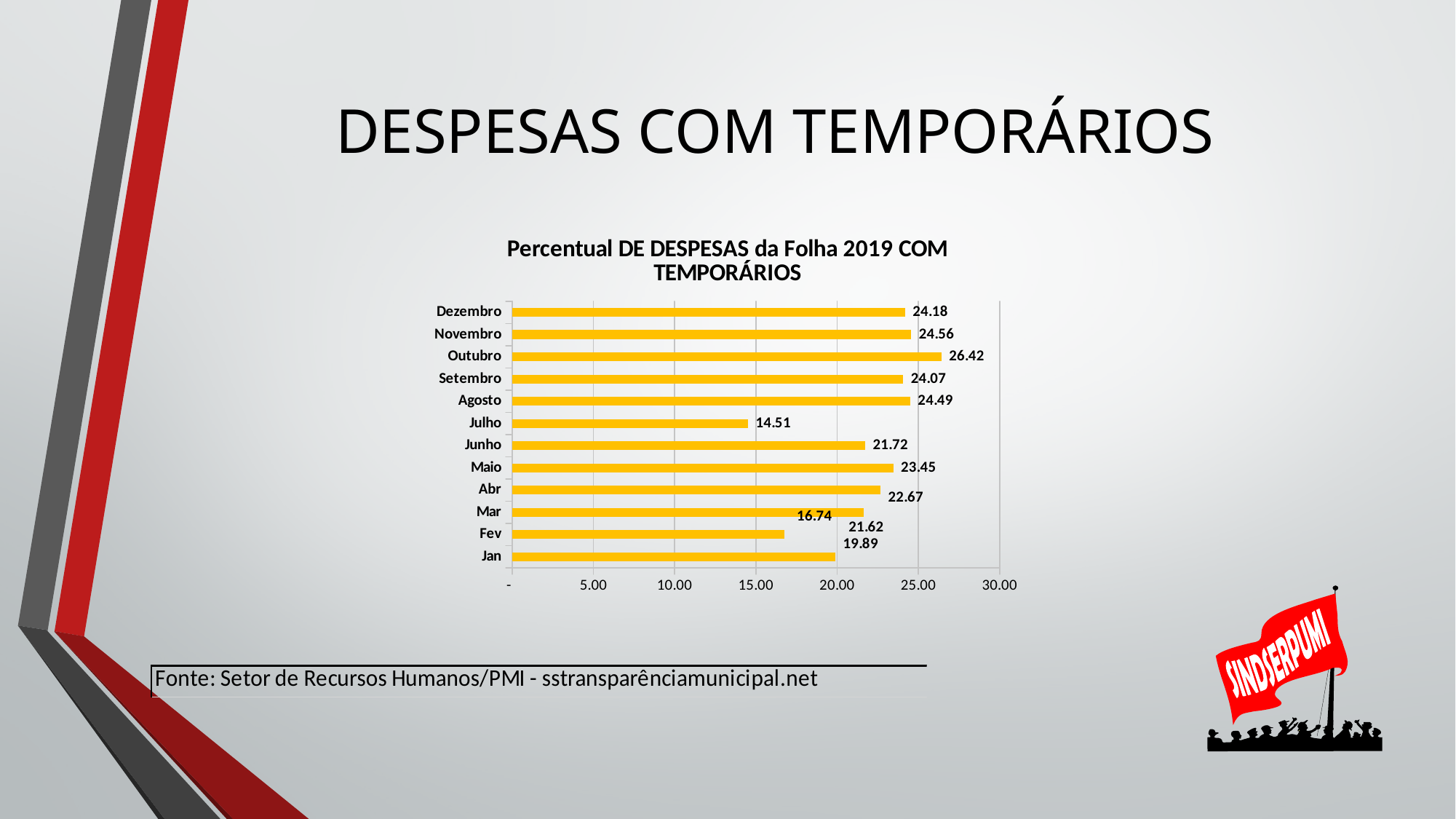
What is the value for Outubro? 26.42 Which is larger, the value for Novembro or the value for Dezembro? Novembro What kind of chart is shown on the slide? bar chart What is the difference between the values for Outubro and Novembro? 1.86 What is the value for Julho? 14.51 What is the value for Agosto? 24.49 How many months are shown in the chart? 12 Which month has the highest value? Outubro What is the value for Maio? 23.45 What is the title of the chart? Percentual DE DESPESAS da Folha 2019 COM TEMPORÁRIOS Is the value for Julho greater or less than 15.00? less Which month has the lowest value? Julho